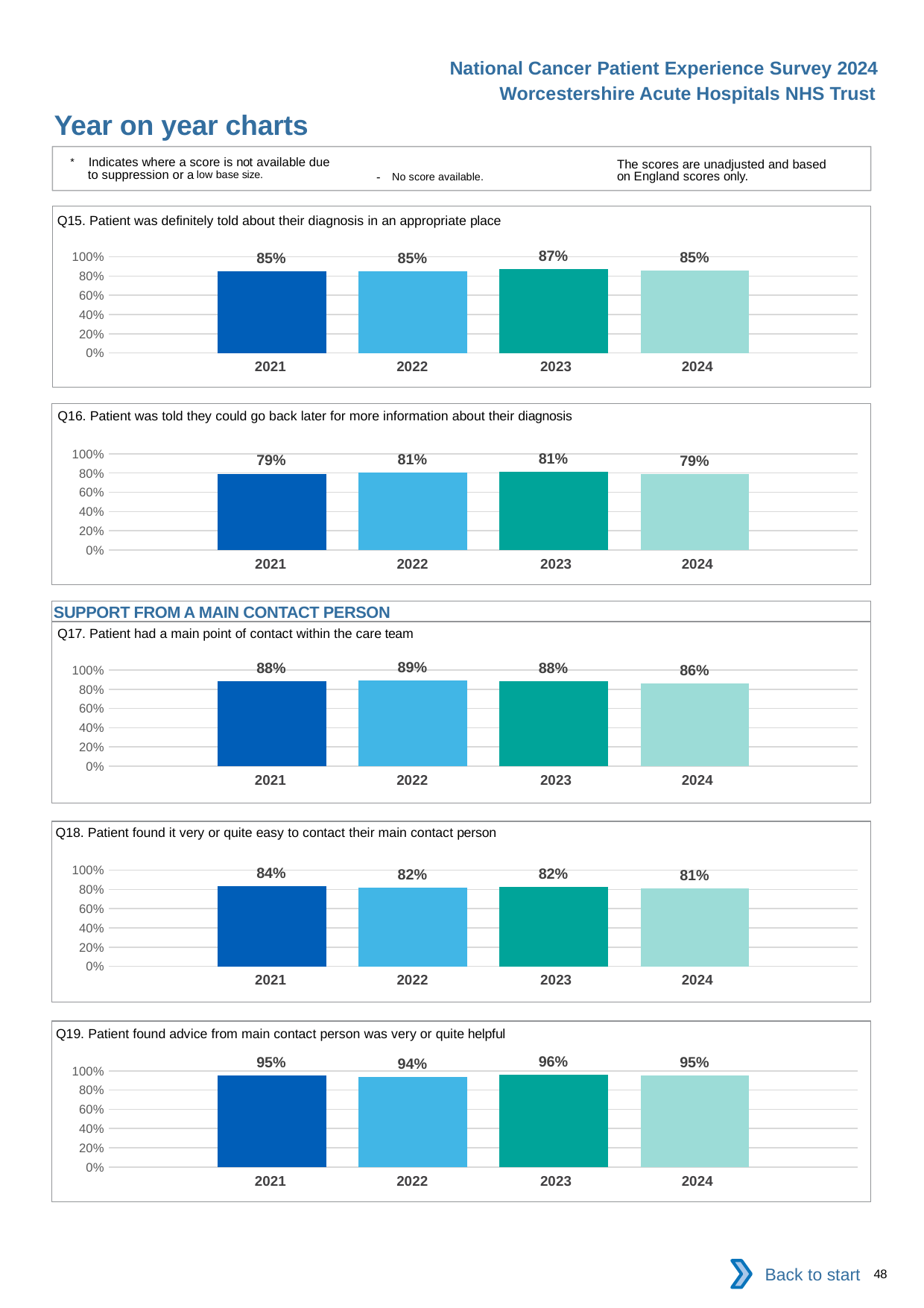
In the Q18 chart (patient found it very or quite easy to contact their main contact person), do the values rise or fall from 2021 to 2024? fall In the Q15 chart (patient was definitely told about their diagnosis in an appropriate place), what is the value for 2023? 87% In the Q19 chart, is the value for 2022 larger or smaller than the value for 2024? smaller What kind of chart is used for Q19? bar chart In the Q17 chart, what is the value for 2022? 89% In the Q16 chart, what is the difference between the 2022 value and the 2021 value? 2% In the Q19 chart (patient found advice from main contact person was very or quite helpful), which year has the highest value? 2023 How many years are shown on the x axis of the Q15 chart? 4 In the Q17 chart (patient had a main point of contact within the care team), which year has the lowest value? 2024 In the Q16 chart (patient was told they could go back later for more information about their diagnosis), what is the value for 2024? 79% In the Q18 chart, what is the difference between the 2021 value and the 2024 value? 3% In the Q15 chart, which year has the highest value? 2023